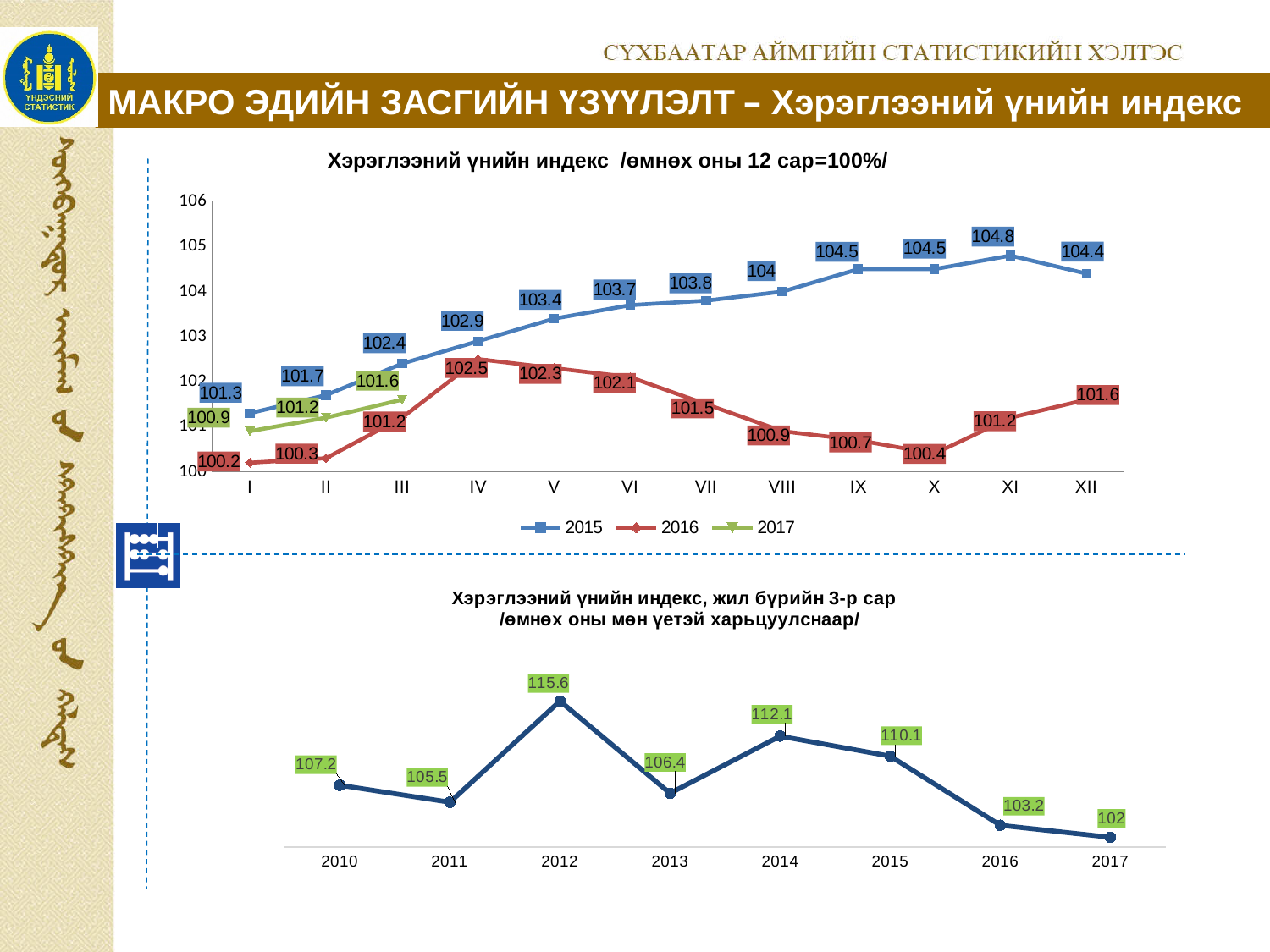
In the top chart, what is the value for the 2015 series in month XI? 104.8 In the top chart, what is the difference between the 2015 and 2016 values in month XII? 2.8 In the top chart, how many series does the legend list? 3 In the top chart, what is the value for the 2016 series in month X? 100.4 What type of chart is the bottom chart? Line chart In the bottom chart, which year has the lowest value? 2017 In the top chart, which month has the highest value for the 2016 series? IV In the top chart, what is the value for the 2017 series in month III? 101.6 In the top chart, which is larger in month II: the 2015 value or the 2017 value? 2015 In the bottom chart, what is the value for 2012? 115.6 In the bottom chart, how many years are plotted? 8 In the bottom chart, what is the difference between the values for 2014 and 2015? 2